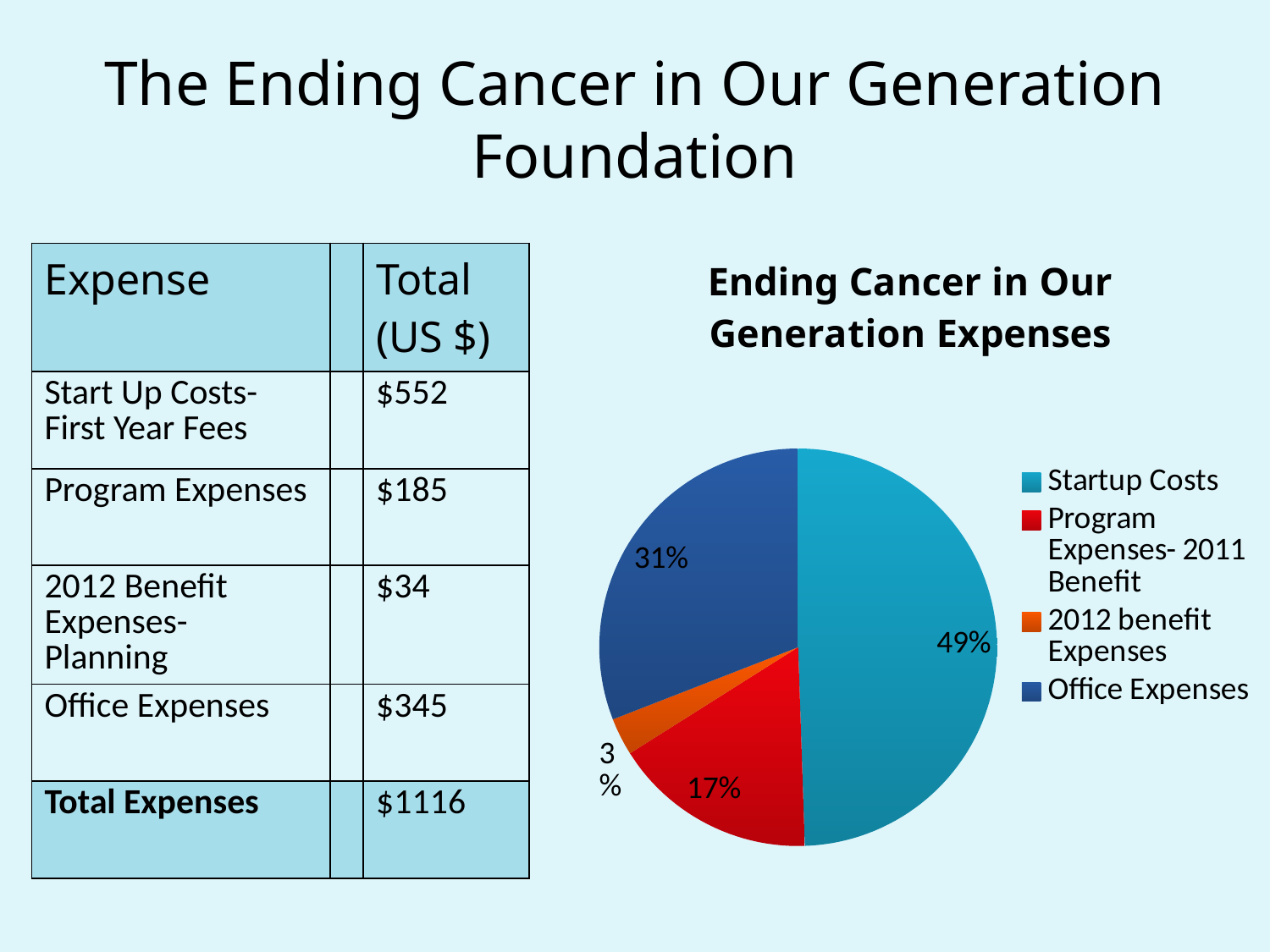
What share of the pie is Program Expenses- 2011 Benefit? 17% How many entries does the legend list? 4 What share of the pie is Startup Costs? 49% Which is larger, the Office Expenses slice or the Program Expenses- 2011 Benefit slice? Office Expenses How many slices does the pie chart have? 4 Which category has the smallest slice of the pie? 2012 benefit Expenses What is the difference in percentage points between the Startup Costs slice and the Office Expenses slice? 18% What share of the pie is Office Expenses? 31% What is the title of the chart? Ending Cancer in Our Generation Expenses What kind of chart is shown on the slide? pie chart Which category has the largest slice of the pie? Startup Costs